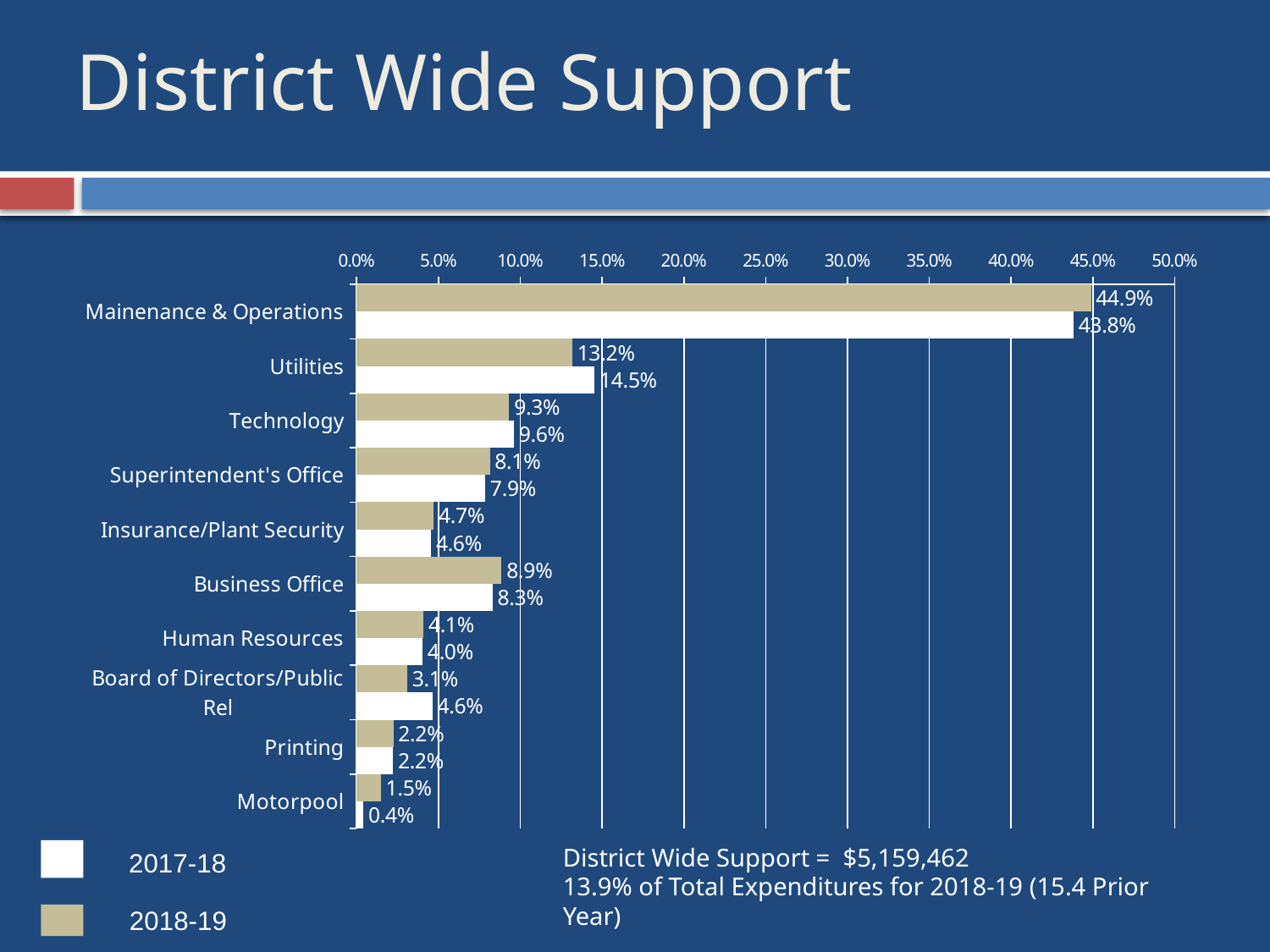
Which is larger for Utilities: the 2017-18 value or the 2018-19 value? 2017-18 What is the 2018-19 value for Utilities? 13.2% Which category has the lowest 2017-18 value? Motorpool What is the 2018-19 value for Business Office? 8.9% What is the difference between the 2018-19 and 2017-18 values for Board of Directors/Public Rel? 1.5% How many series does the legend list? 2 Is the 2018-19 value for Mainenance & Operations greater or less than 40.0%? greater How many categories are shown on the chart? 10 Which category has the highest 2018-19 value? Mainenance & Operations What kind of chart is shown on the slide? bar chart What is the 2017-18 value for Motorpool? 0.4% What is the 2017-18 value for Technology? 9.6%